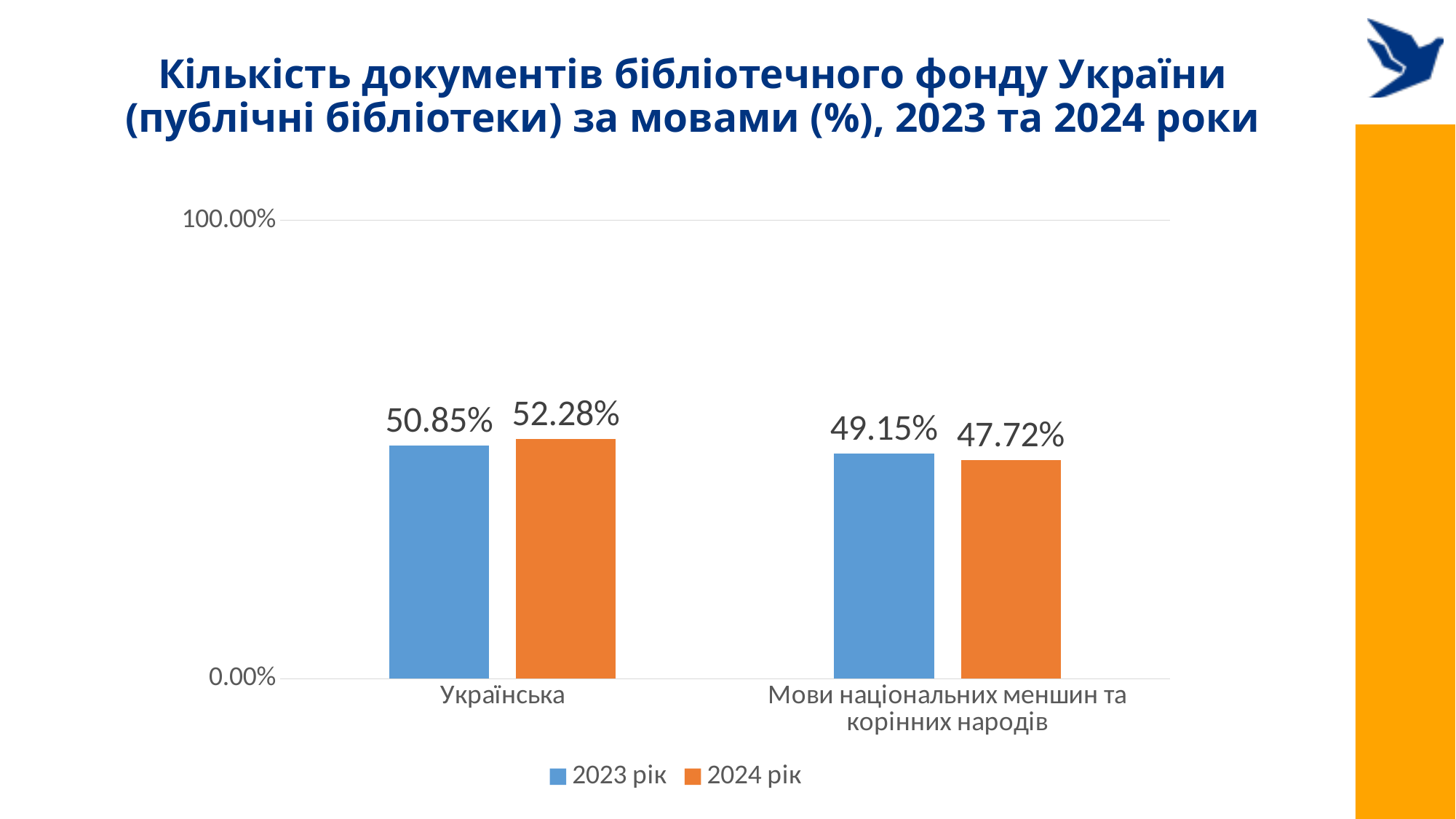
Which category has the lowest value in the 2023 рік series? Мови національних меншин та корінних народів How many categories are shown on the x axis? 2 How many series does the legend list? 2 What is the difference between the 2024 рік and 2023 рік values for Українська? 1.43% What is the value for Мови національних меншин та корінних народів in 2023 рік? 49.15% Which category has the highest value in the 2024 рік series? Українська What is the value for Українська in 2023 рік? 50.85% What is the difference between the 2023 рік and 2024 рік values for Мови національних меншин та корінних народів? 1.43% What is the value for Українська in 2024 рік? 52.28% Which is larger: the 2023 рік value for Українська or the 2023 рік value for Мови національних меншин та корінних народів? Українська What is the value for Мови національних меншин та корінних народів in 2024 рік? 47.72% What kind of chart is shown on the slide? Bar chart